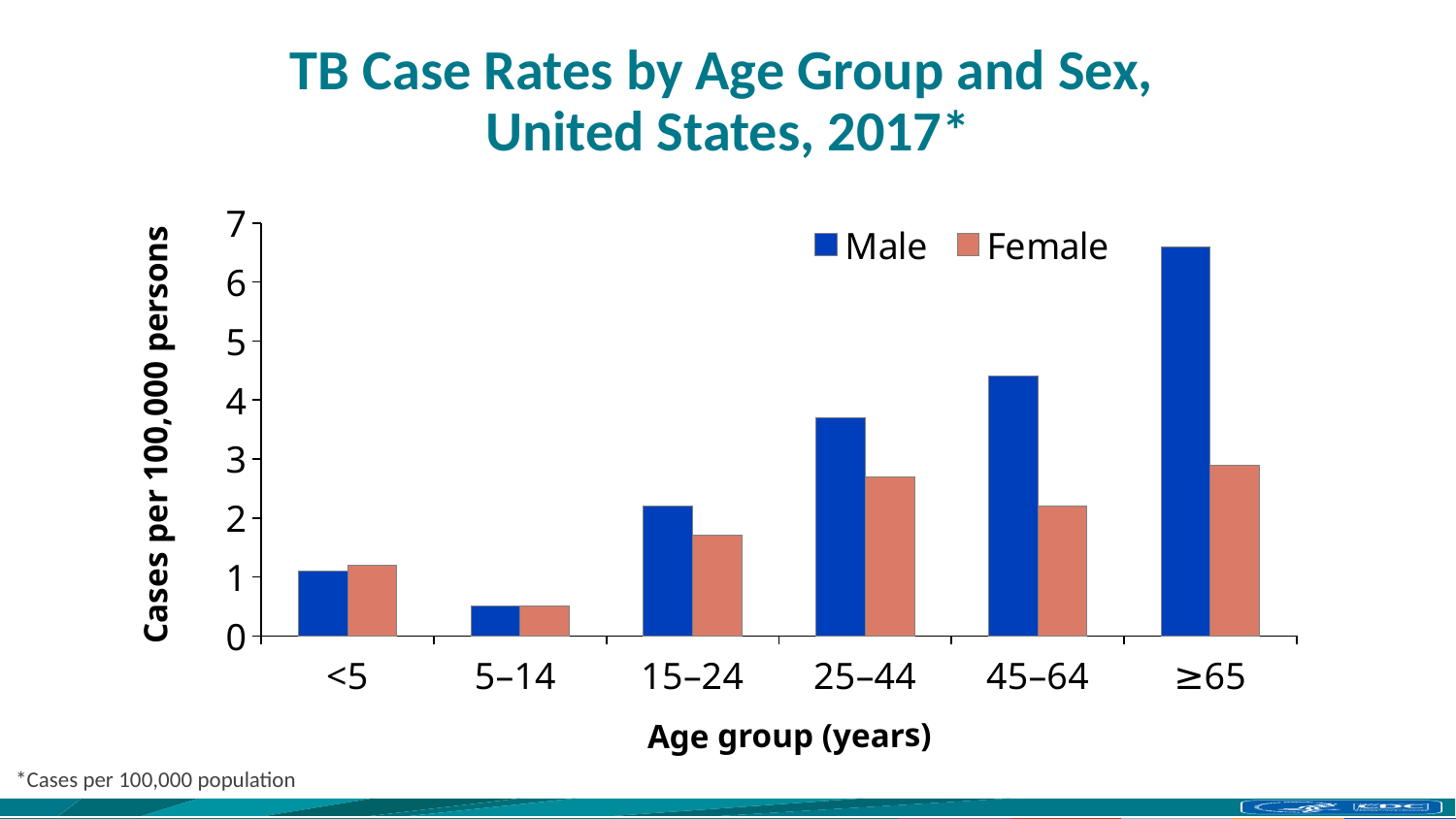
Is the Female value for 25–44 greater or less than 3? less Which age group has the lowest Female case rate? 5–14 Is the Male value for 45–64 greater or less than 4? greater Is the Male value for ≥65 greater or less than 6? greater For the 45–64 age group, which is larger, the Male or the Female case rate? Male What is the label of the y axis? Cases per 100,000 persons Which age group has the highest Male case rate? ≥65 What kind of chart is shown on the slide? bar chart How many series does the legend list? 2 How many age groups are shown on the x axis? 6 From the 15–24 age group to the ≥65 age group, do the Male case rates rise or fall? rise